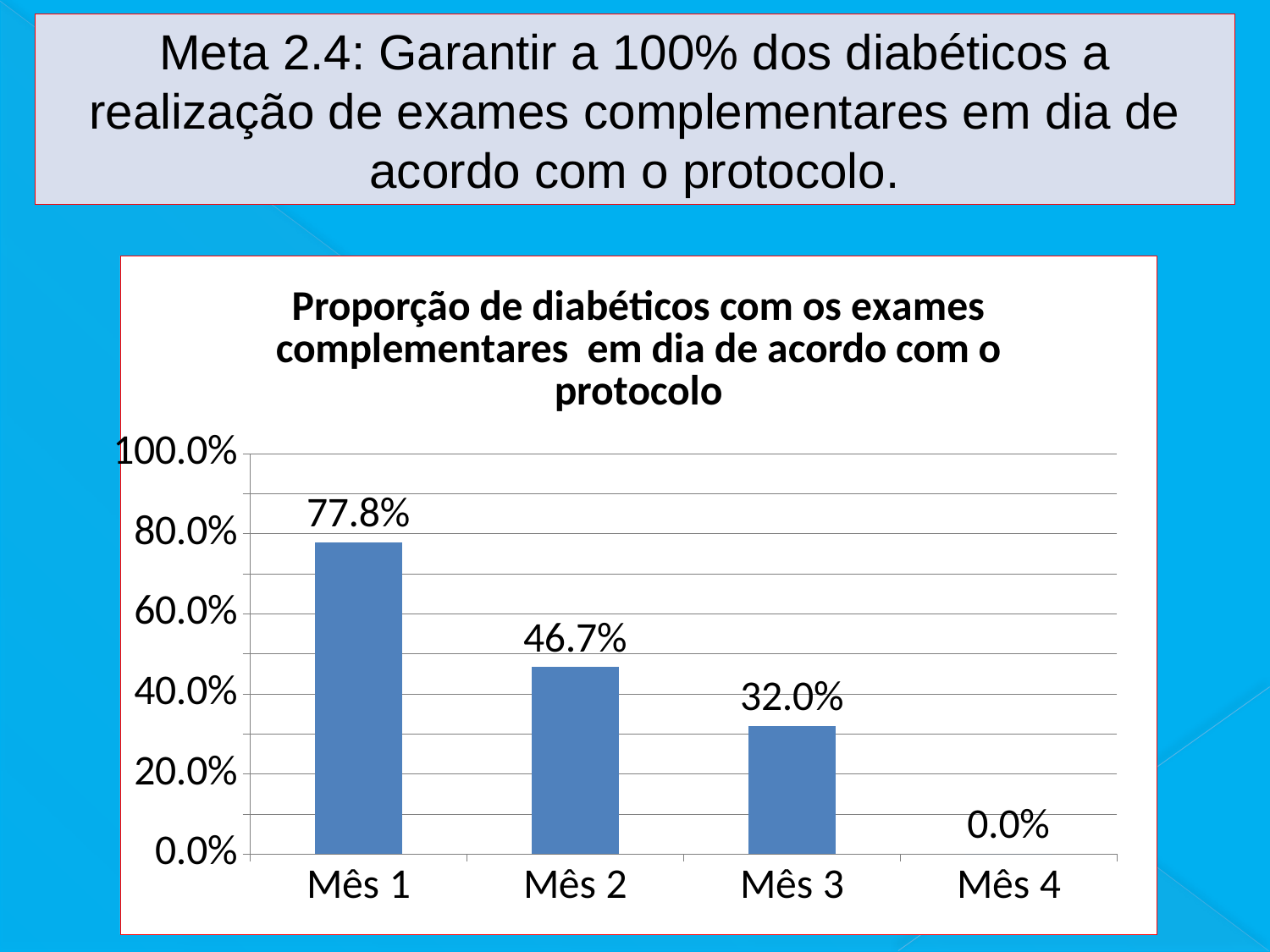
How many months are shown on the x axis? 4 What is the difference between the values for Mês 2 and Mês 3? 14.7% Do the values rise or fall from Mês 1 to Mês 4? Fall What is the value for Mês 2? 46.7% Which month has the highest value? Mês 1 What is the difference between the values for Mês 1 and Mês 2? 31.1% What is the value for Mês 3? 32.0% What kind of chart is shown? Bar chart What is the value for Mês 4? 0.0% Which month has the lowest value? Mês 4 Which is larger, the value for Mês 2 or the value for Mês 3? Mês 2 What is the value for Mês 1? 77.8%